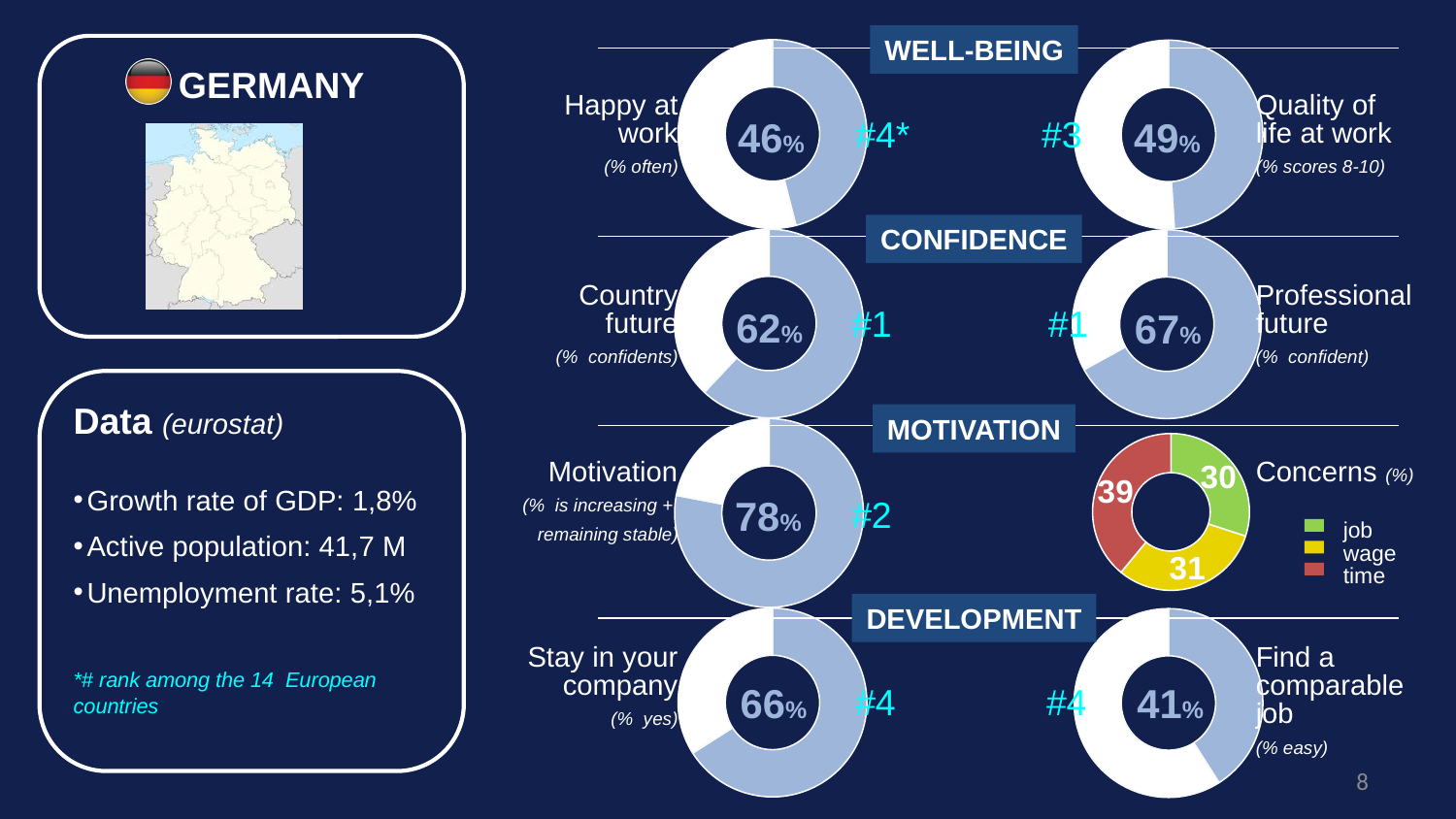
On the 'Happy at work' donut chart, what percentage is shown in the centre? 46% On the 'Motivation' donut chart, what percentage is shown? 78% What is the difference between the 'Stay in your company' donut value and the 'Find a comparable job' donut value? 25% On the 'Concerns' pie chart, which category has the smallest value? job On the 'Quality of life at work' donut chart, what percentage is shown? 49% On the 'Concerns' pie chart, which category has the largest value? time On the 'Concerns' pie chart, what is the difference between the 'time' value and the 'job' value? 9 On the 'Professional future' donut chart, what percentage is shown? 67% On the 'Concerns' pie chart, what is the value for 'time'? 39 Which is larger: the 'Country future' donut value or the 'Professional future' donut value? Professional future How many categories does the legend of the 'Concerns' pie chart list? 3 What type of chart is used for 'Concerns'? Doughnut chart